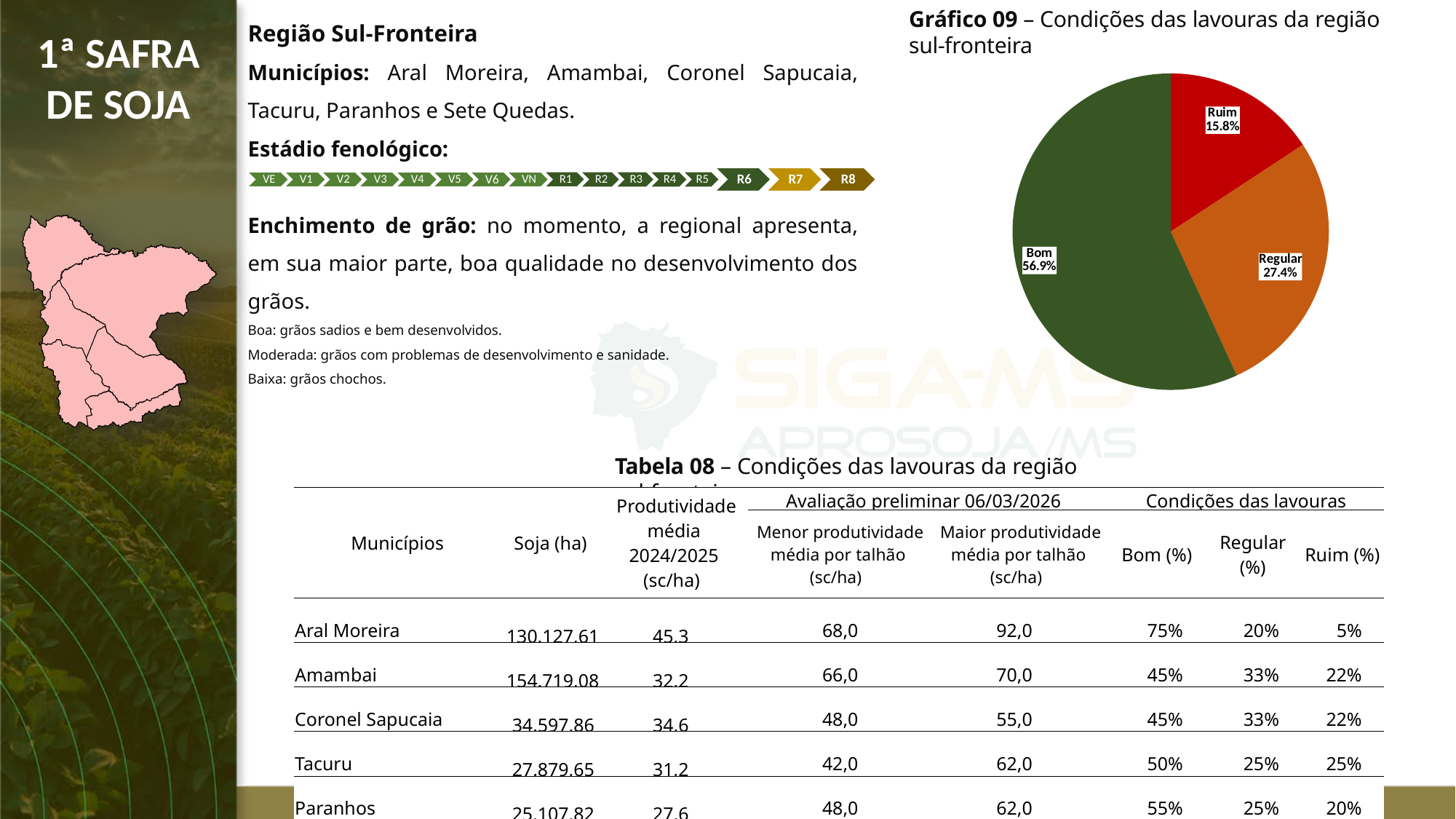
In Gráfico 09, which category has the largest slice? Bom In Gráfico 09, what colour is the Ruim slice? red In Gráfico 09, which category has the smallest slice? Ruim In Gráfico 09, what share of the pie is labelled Regular? 27.4% In Gráfico 09, what share of the pie is labelled Bom? 56.9% How many slices does the pie in Gráfico 09 have? 3 What kind of chart is Gráfico 09? pie chart In Gráfico 09, what share of the pie is labelled Ruim? 15.8% In Gráfico 09, what is the difference in percentage points between the Bom and Regular slices? 29.5 In Gráfico 09, which slice is larger, Regular or Ruim? Regular What is the title of the pie chart on the slide? Gráfico 09 – Condições das lavouras da região sul-fronteira In Gráfico 09, what is the difference in percentage points between the Regular and Ruim slices? 11.6